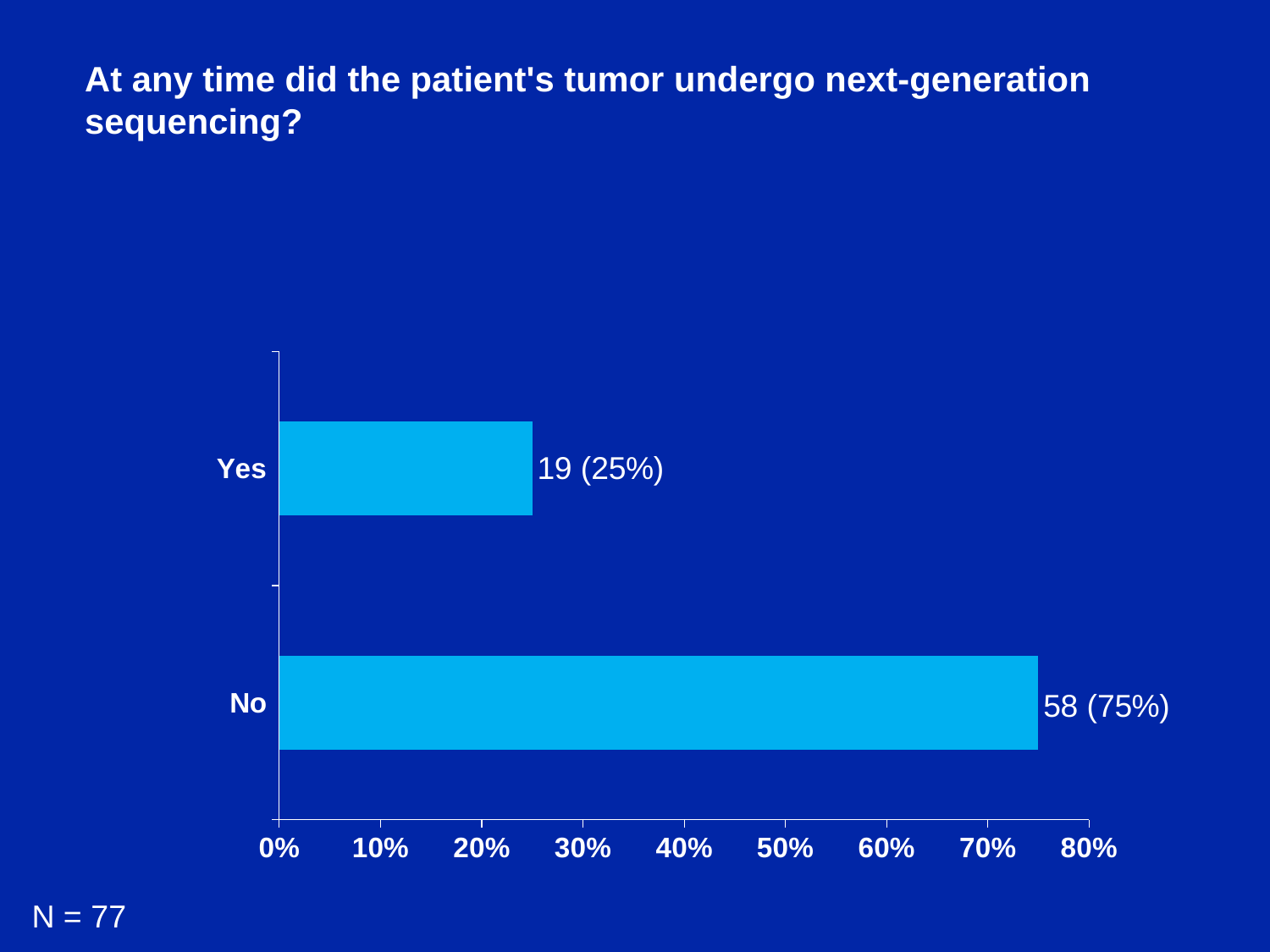
Which is larger, the value for "Yes" or the value for "No"? No What is the data label shown for the "No" bar? 58 (75%) Which category has the lowest value? Yes How many patients answered "No"? 58 What is the difference in percentage points between the "No" and "Yes" bars? 50% What percentage of patients' tumors underwent next-generation sequencing ("Yes")? 25% Which category has the highest value? No What kind of chart is shown on the slide? Bar chart What is the data label shown for the "Yes" bar? 19 (25%) Is the value for "No" greater or less than 50%? greater How many more patients answered "No" than "Yes"? 39 How many categories are shown in the chart? 2